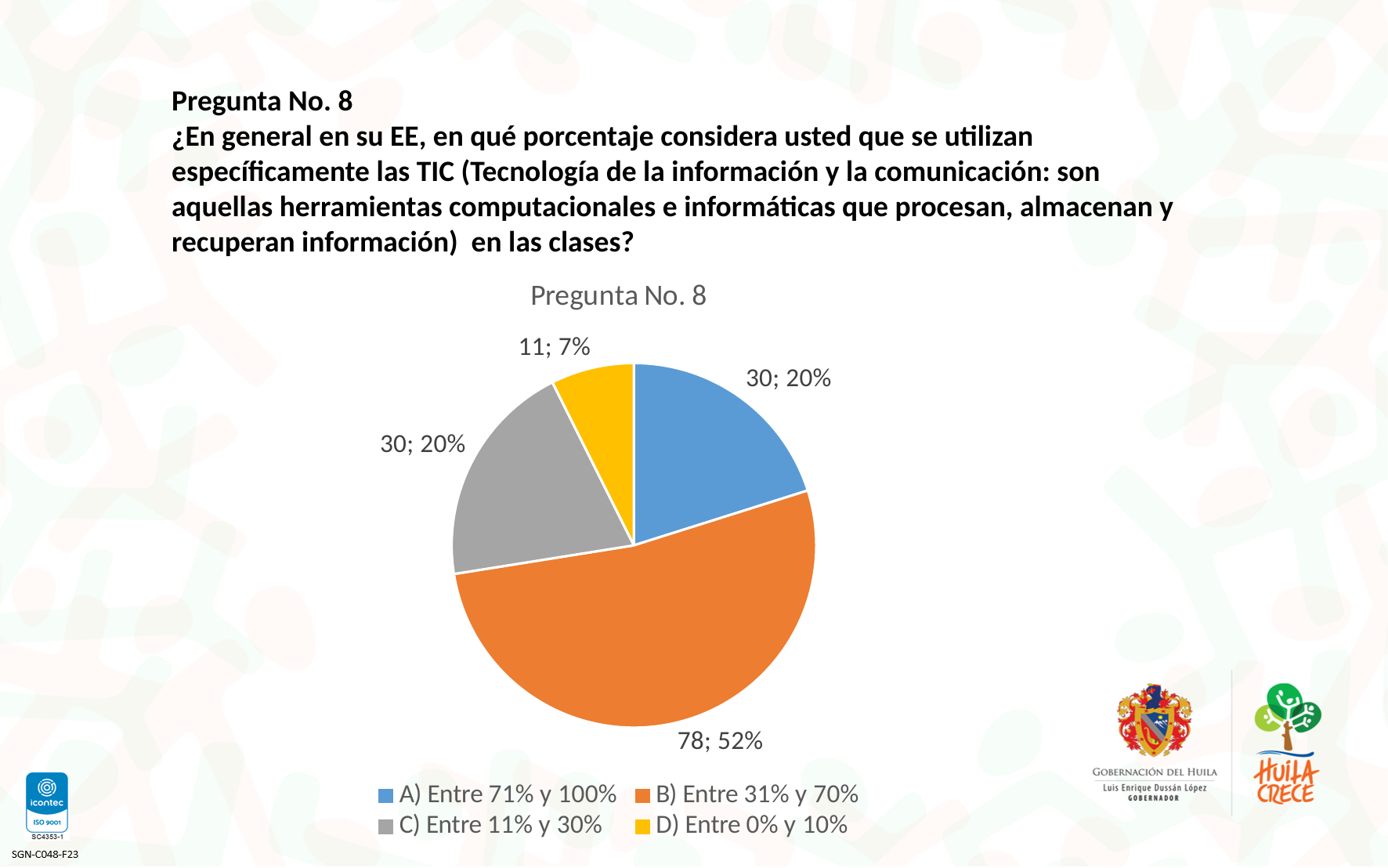
What is the count for "A) Entre 71% y 100%"? 30 What kind of chart is shown on the slide? pie chart Which category has the largest slice? B) Entre 31% y 70% What share of the pie does "C) Entre 11% y 30%" represent? 20% Which colour represents "C) Entre 11% y 30%" in the legend? gray What is the count for "B) Entre 31% y 70%"? 78 What share of the pie does "B) Entre 31% y 70%" represent? 52% What is the title of the chart? Pregunta No. 8 How many slices does the pie chart have? 4 What is the count for "D) Entre 0% y 10%"? 11 What is the difference between the counts for "B) Entre 31% y 70%" and "A) Entre 71% y 100%"? 48 Which category has the smallest slice? D) Entre 0% y 10%